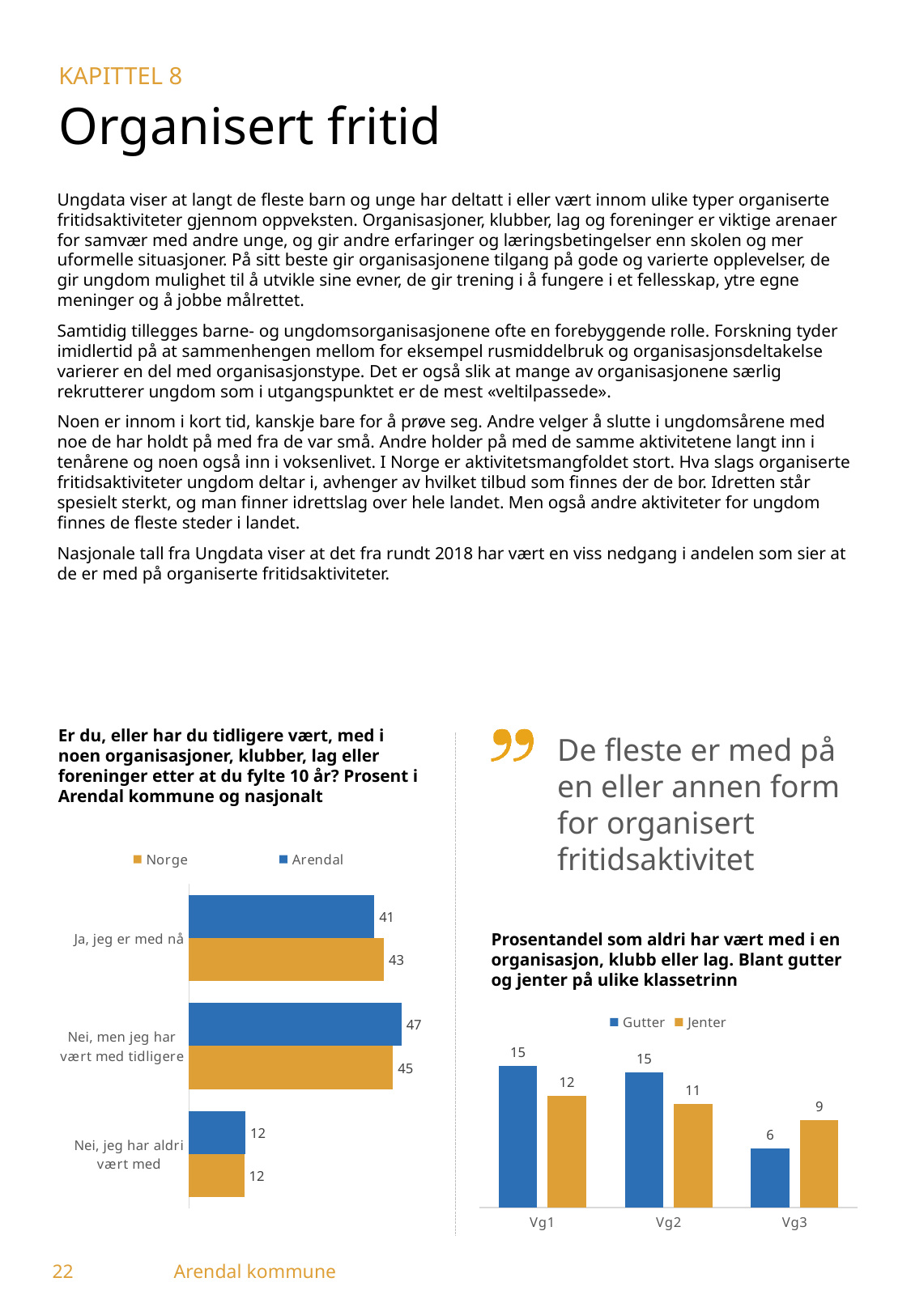
In the left chart (Er du, eller har du tidligere vært, med i noen organisasjoner...), what is the Norge value for "Nei, men jeg har vært med tidligere"? 45 In the right chart (Prosentandel som aldri har vært med i en organisasjon...), what is the Gutter value for Vg3? 6 In the right chart (Prosentandel som aldri har vært med i en organisasjon...), what is the Jenter value for Vg2? 11 In the right chart (Prosentandel som aldri har vært med i en organisasjon...), what is the difference between the Gutter and Jenter values for Vg1? 3 In the left chart (Er du, eller har du tidligere vært, med i noen organisasjoner...), what is the Arendal value for "Ja, jeg er med nå"? 41 In the right chart (Prosentandel som aldri har vært med i en organisasjon...), which class level has the lowest Gutter value? Vg3 In the right chart (Prosentandel som aldri har vært med i en organisasjon...), which is larger for Vg3, Gutter or Jenter? Jenter In the left chart (Er du, eller har du tidligere vært, med i noen organisasjoner...), what kind of chart is shown? Bar chart In the left chart (Er du, eller har du tidligere vært, med i noen organisasjoner...), what is the difference between the Norge and Arendal values for "Ja, jeg er med nå"? 2 In the left chart (Er du, eller har du tidligere vært, med i noen organisasjoner...), how many series does the legend list? 2 In the left chart (Er du, eller har du tidligere vært, med i noen organisasjoner...), which category has the highest Arendal value? Nei, men jeg har vært med tidligere In the right chart (Prosentandel som aldri har vært med i en organisasjon...), how many class levels are shown on the x axis? 3